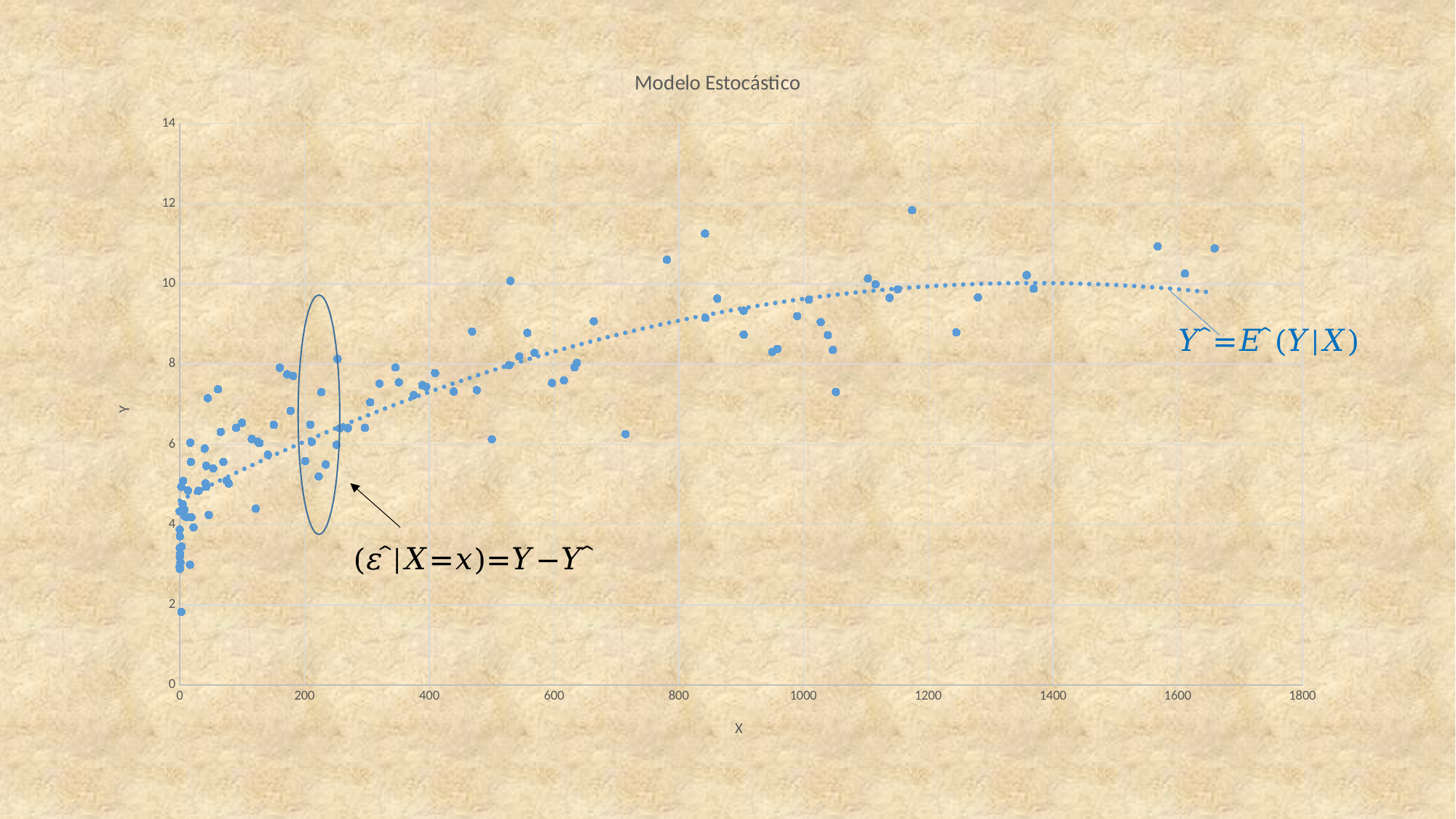
Is the Y value of the lowest plotted point greater or less than 4? less Is the Y value of the dotted trend line at X = 200 greater or less than 8? less What kind of chart is shown on the slide? scatter plot What is the title of the chart? Modelo Estocástico What is the label of the horizontal axis of the chart? X Is the Y value of the dotted trend line at X = 1400 greater or less than 8? greater Do the Y values generally rise or fall as X increases along the x axis? rise